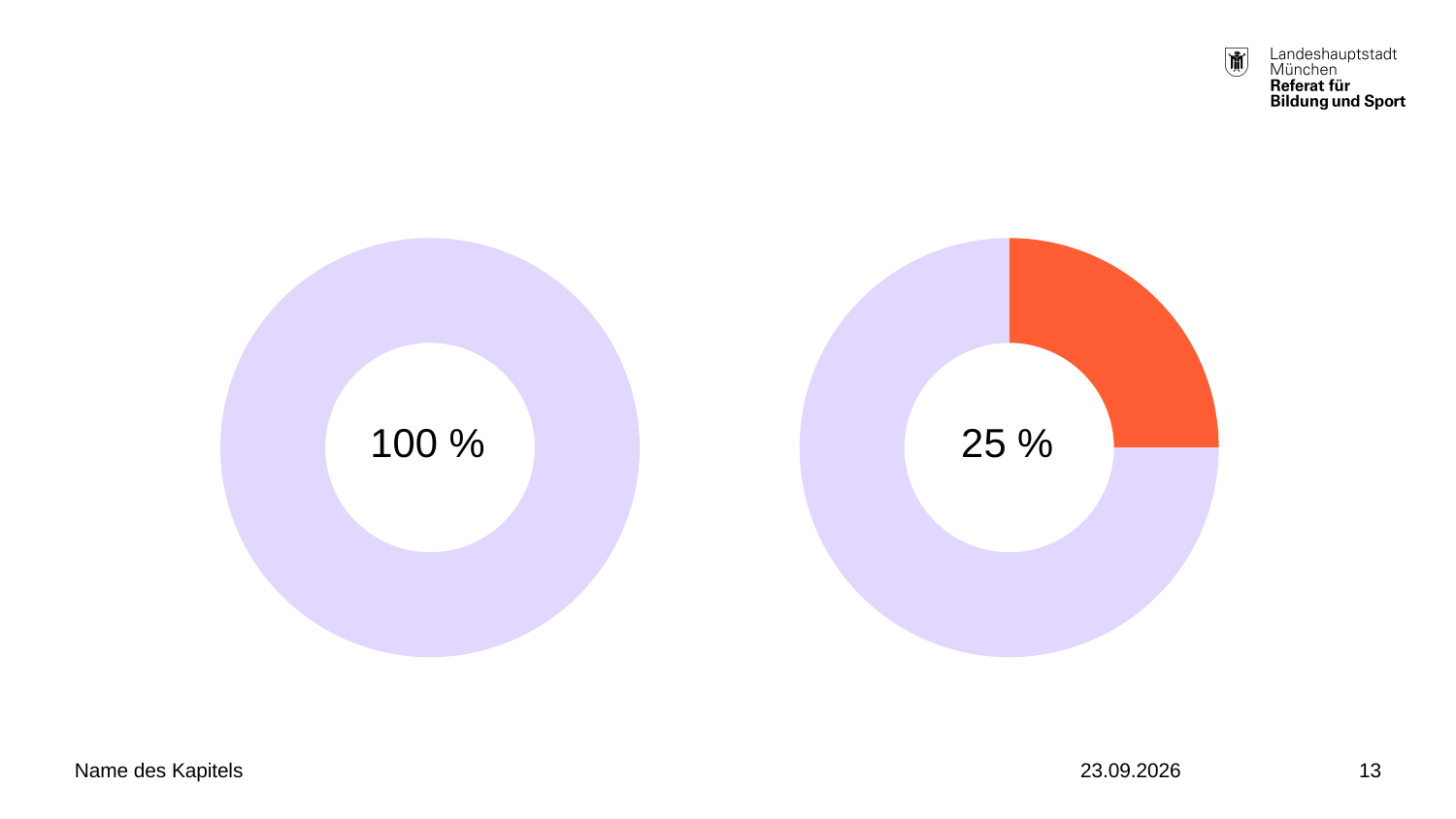
How many differently coloured segments does the right chart have? 2 What kind of chart is shown on the right of the slide? Doughnut (pie) chart What colour is the ring of the left chart? Light purple How many differently coloured segments does the left chart have? 1 What is the difference between the percentage shown in the left chart and the percentage shown in the right chart? 75 % In the right chart, what share of the ring does the orange segment represent? 25 % What kind of chart is shown on the left of the slide? Doughnut (pie) chart What percentage is printed in the centre of the right chart? 25 % What percentage is printed in the centre of the left chart? 100 % What colour is the highlighted segment in the right chart? Orange Which chart shows the larger percentage in its centre, the left or the right one? The left chart How many charts are shown on the slide? 2